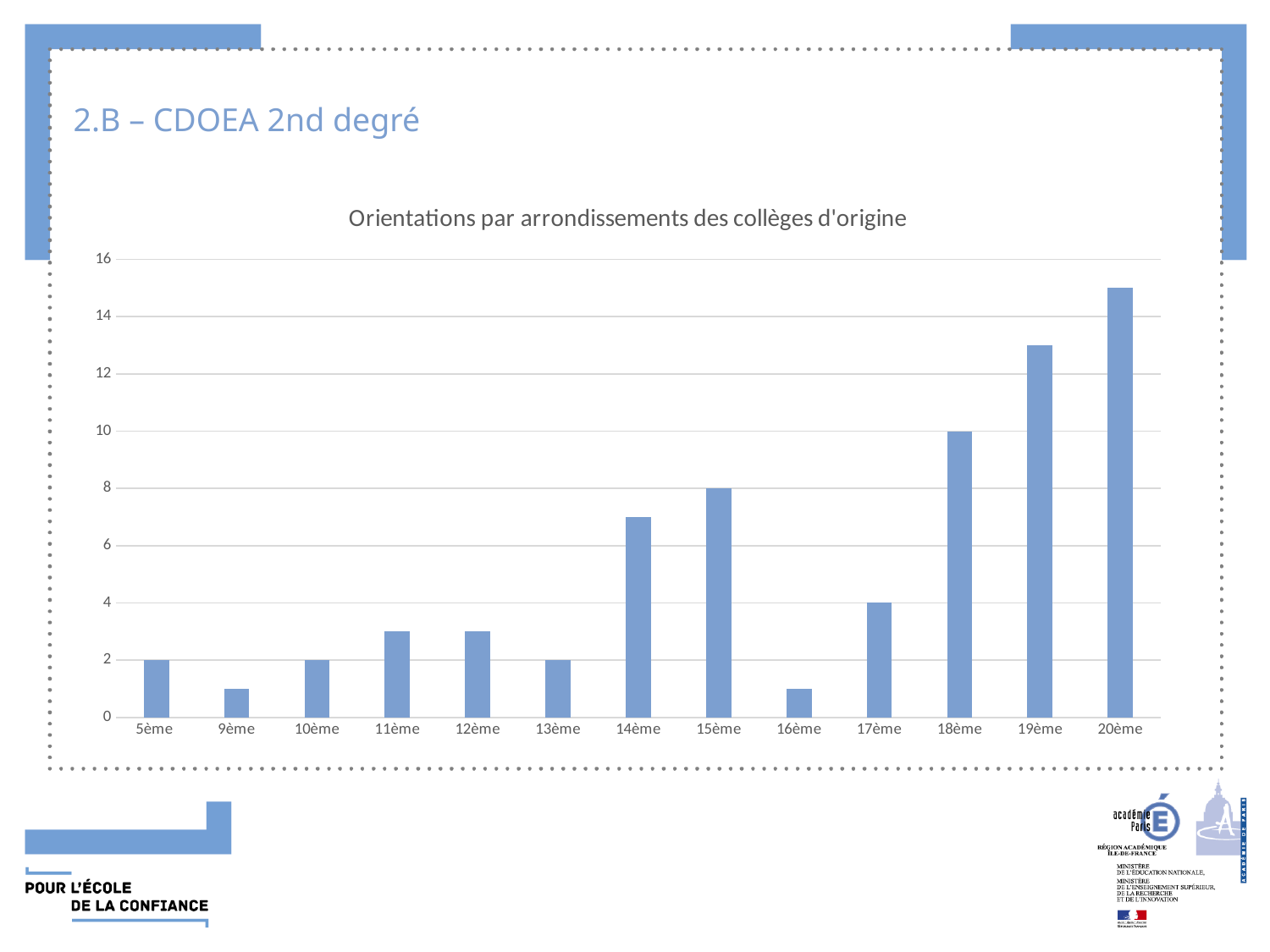
What is the value for 15ème? 8 Which is larger, the value for 19ème or the value for 14ème? 19ème What is the difference between the values for 18ème and 15ème? 2 Which arrondissement has the highest value? 20ème What is the value for 17ème? 4 What is the title of the chart? Orientations par arrondissements des collèges d'origine Is the value for 9ème greater or less than 2? less Is the value for 20ème greater or less than 14? greater What is the value for 5ème? 2 What type of chart is shown on the slide? bar chart How many arrondissements are shown on the x axis? 13 What is the value for 18ème? 10